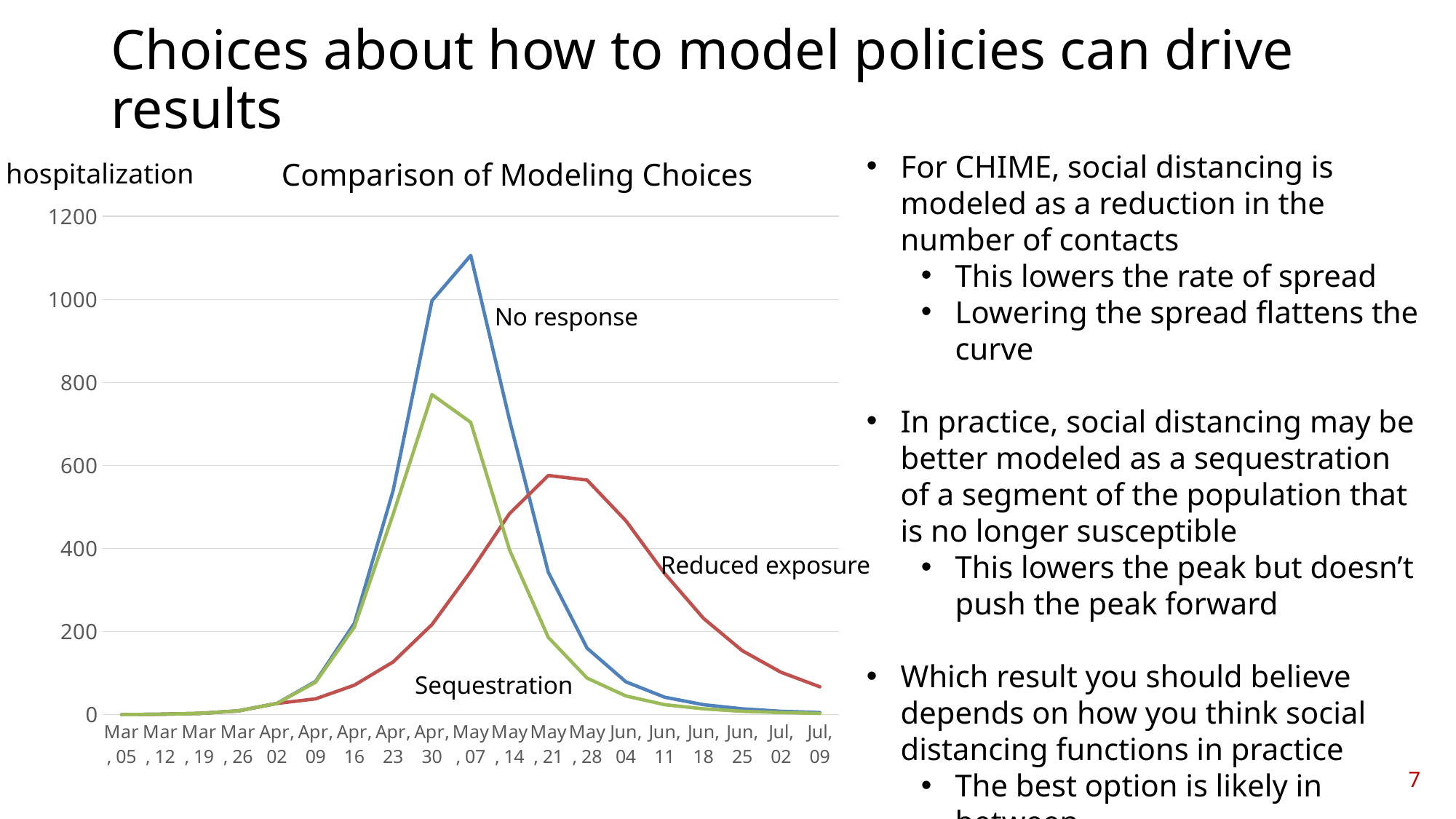
At Jun 04, which line is higher: Reduced exposure or No response? Reduced exposure How many dates are shown along the x axis of the chart? 19 Is the peak value of the Sequestration line greater or less than 800? less Is the peak value of the Reduced exposure line greater or less than 400? greater Is the peak value of the No response line greater or less than 1000? greater Which series reaches the highest peak on the chart? No response What is the title of the chart? Comparison of Modeling Choices How many series (lines) are plotted on the chart? 3 Which series has the lowest peak on the chart? Reduced exposure Does the Sequestration line rise or fall between May 07 and Jul 09? fall At May 07, which line is higher: No response or Sequestration? No response What kind of chart is shown on the slide? line chart